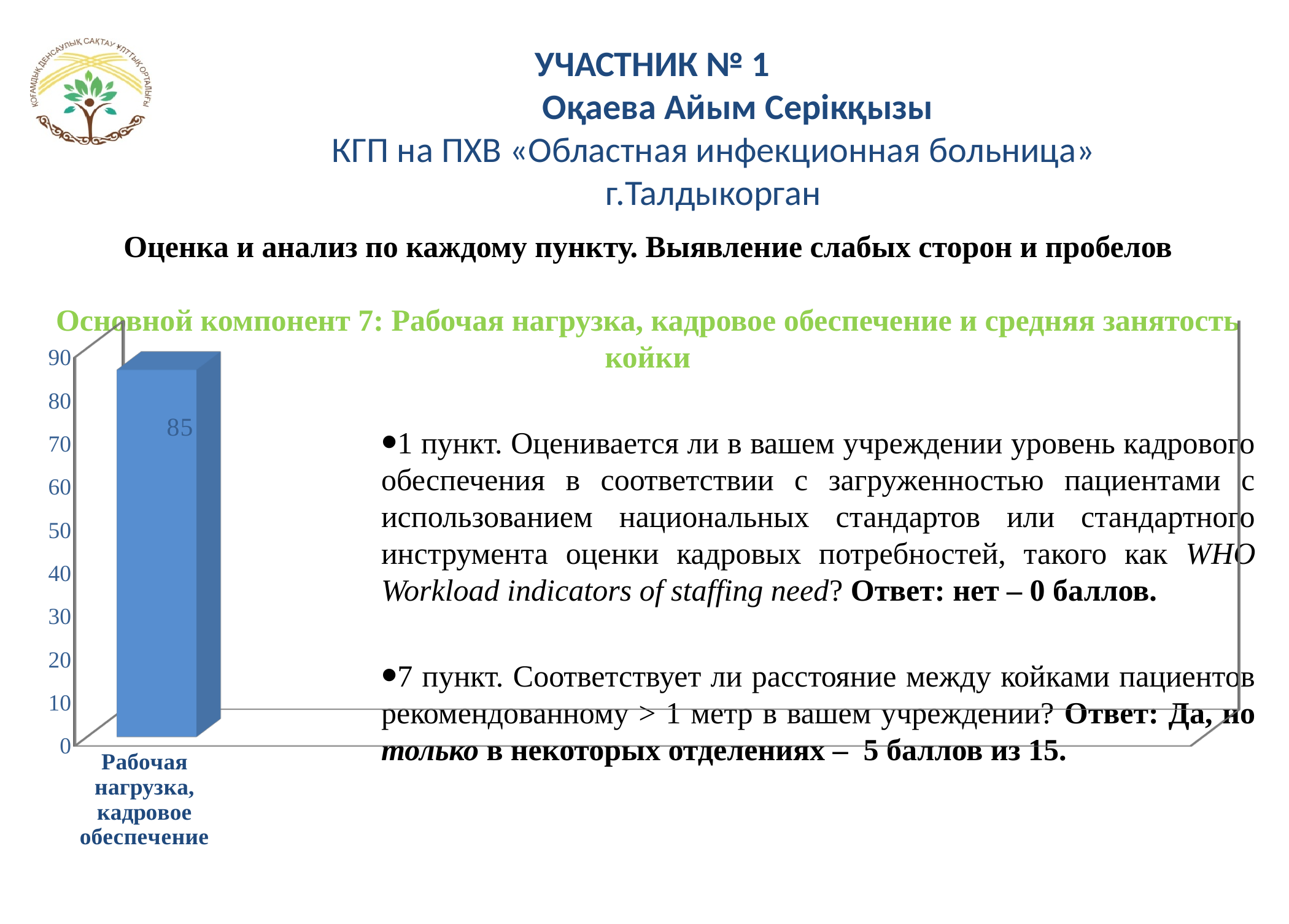
What is the value shown for the bar labelled «Рабочая нагрузка, кадровое обеспечение»? 85 Is the value for «Рабочая нагрузка, кадровое обеспечение» greater or less than 80? greater What is the label of the single category on the horizontal axis of the chart? Рабочая нагрузка, кадровое обеспечение How many bars (categories) does the chart contain? 1 Is the value for «Рабочая нагрузка, кадровое обеспечение» greater or less than 90? less What is the highest tick value shown on the vertical axis of the chart? 90 What kind of chart is shown on the slide? bar chart What colour is the bar in the chart? blue